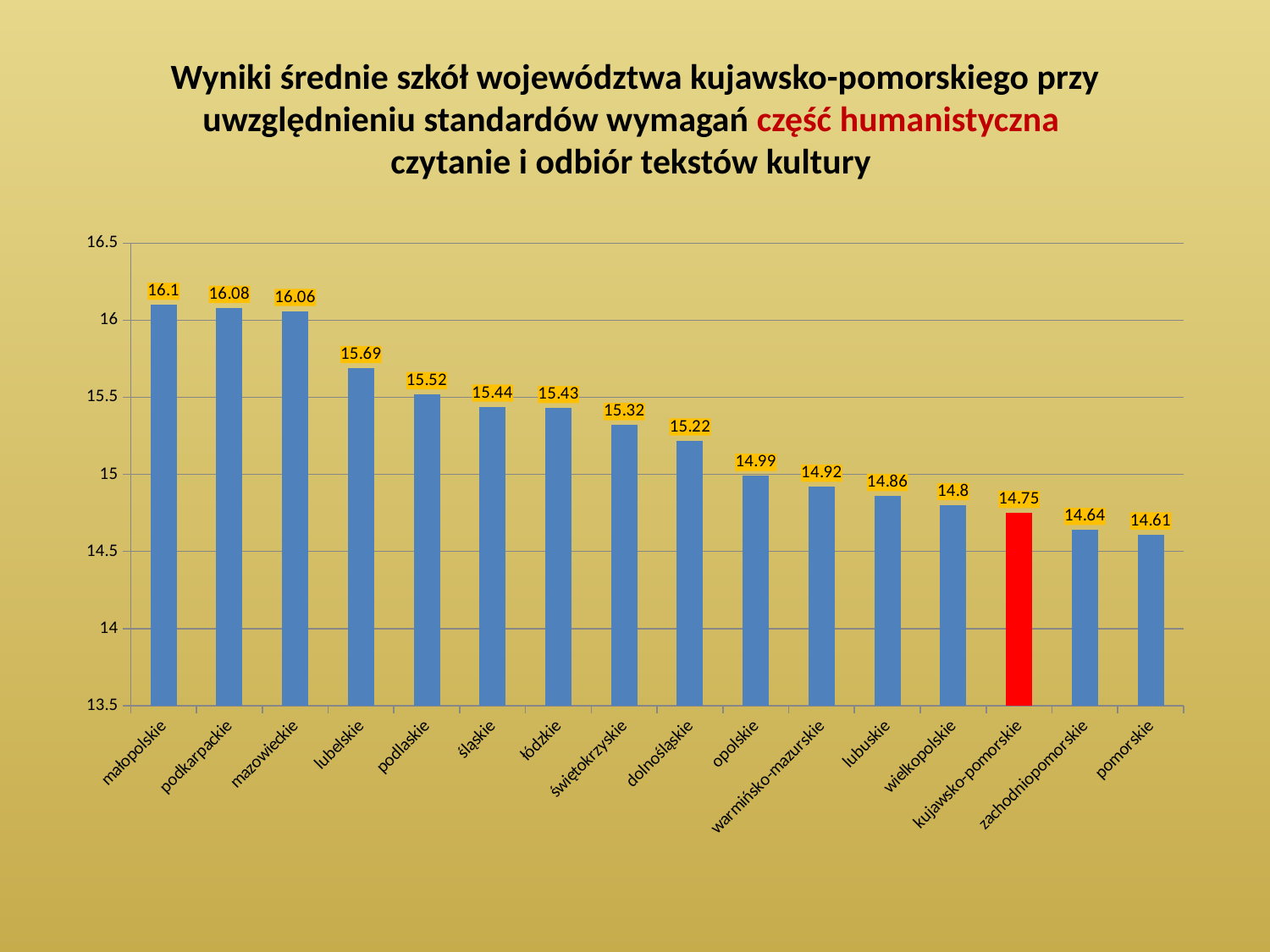
What kind of chart is shown on the slide? bar chart What is the value for lubelskie? 15.69 What is the difference between the values for kujawsko-pomorskie and wielkopolskie? 0.05 Is the value for świętokrzyskie greater or less than 15? greater Which bar is coloured red instead of blue? kujawsko-pomorskie Which voivodeship has the lowest value? pomorskie Which has a larger value, podlaskie or dolnośląskie? podlaskie What is the difference between the values for małopolskie and pomorskie? 1.49 What is the value for kujawsko-pomorskie? 14.75 What is the value for opolskie? 14.99 How many voivodeships are shown on the chart? 16 Which voivodeship has the highest value? małopolskie